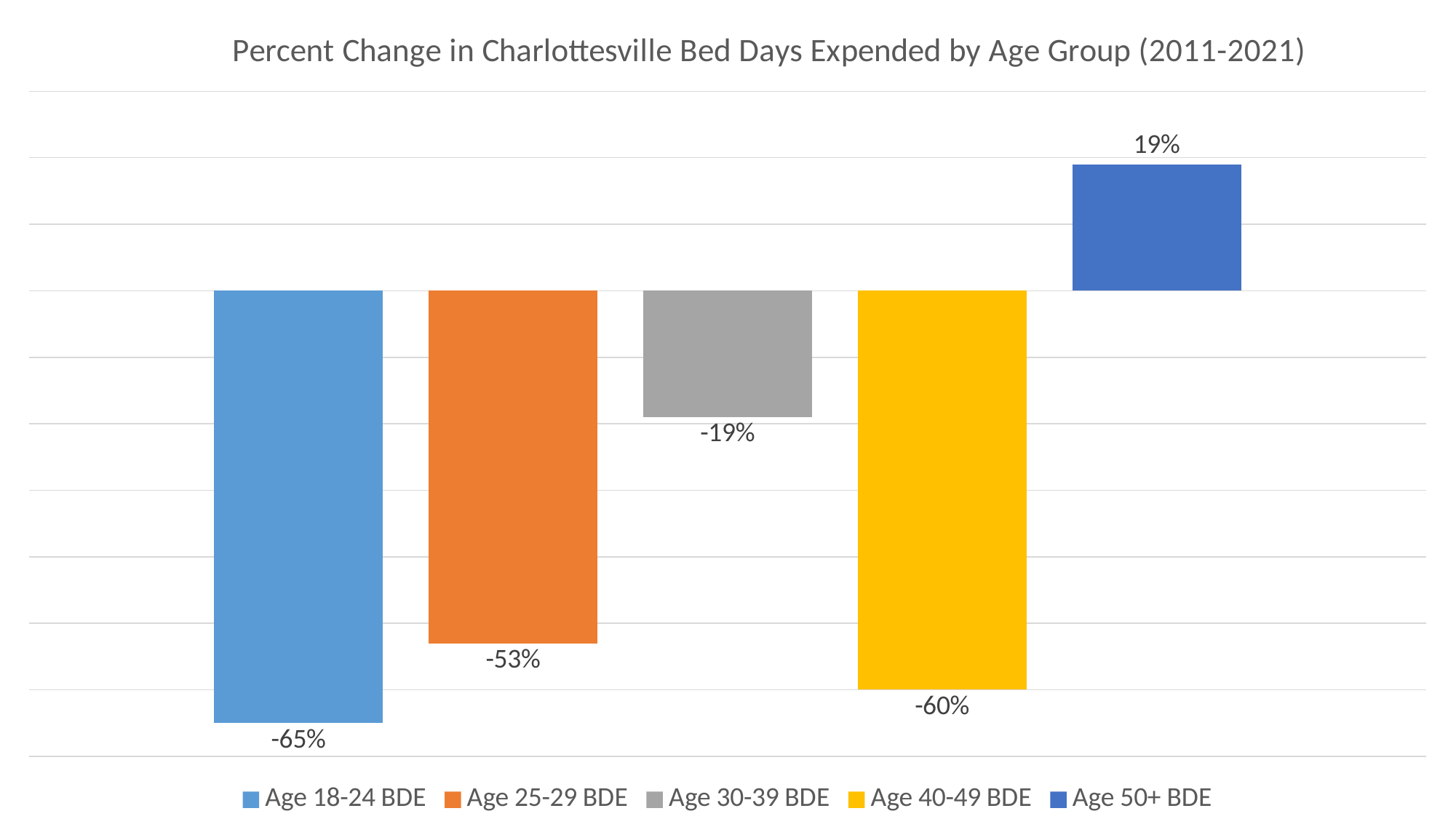
How many age groups are shown in the chart? 5 Which age group has the highest percent change in bed days expended? Age 50+ BDE What kind of chart is shown on the slide? Bar chart What is the title of the chart? Percent Change in Charlottesville Bed Days Expended by Age Group (2011-2021) What is the percent change in bed days expended for Age 30-39 BDE? -19% What is the percent change in bed days expended for Age 50+ BDE? 19% What is the difference between the percent change for Age 25-29 BDE and Age 30-39 BDE? 34 percentage points How many entries does the legend list? 5 Which age group has the lowest percent change in bed days expended? Age 18-24 BDE What is the percent change in bed days expended for Age 40-49 BDE? -60% What is the percent change in bed days expended for Age 18-24 BDE? -65%